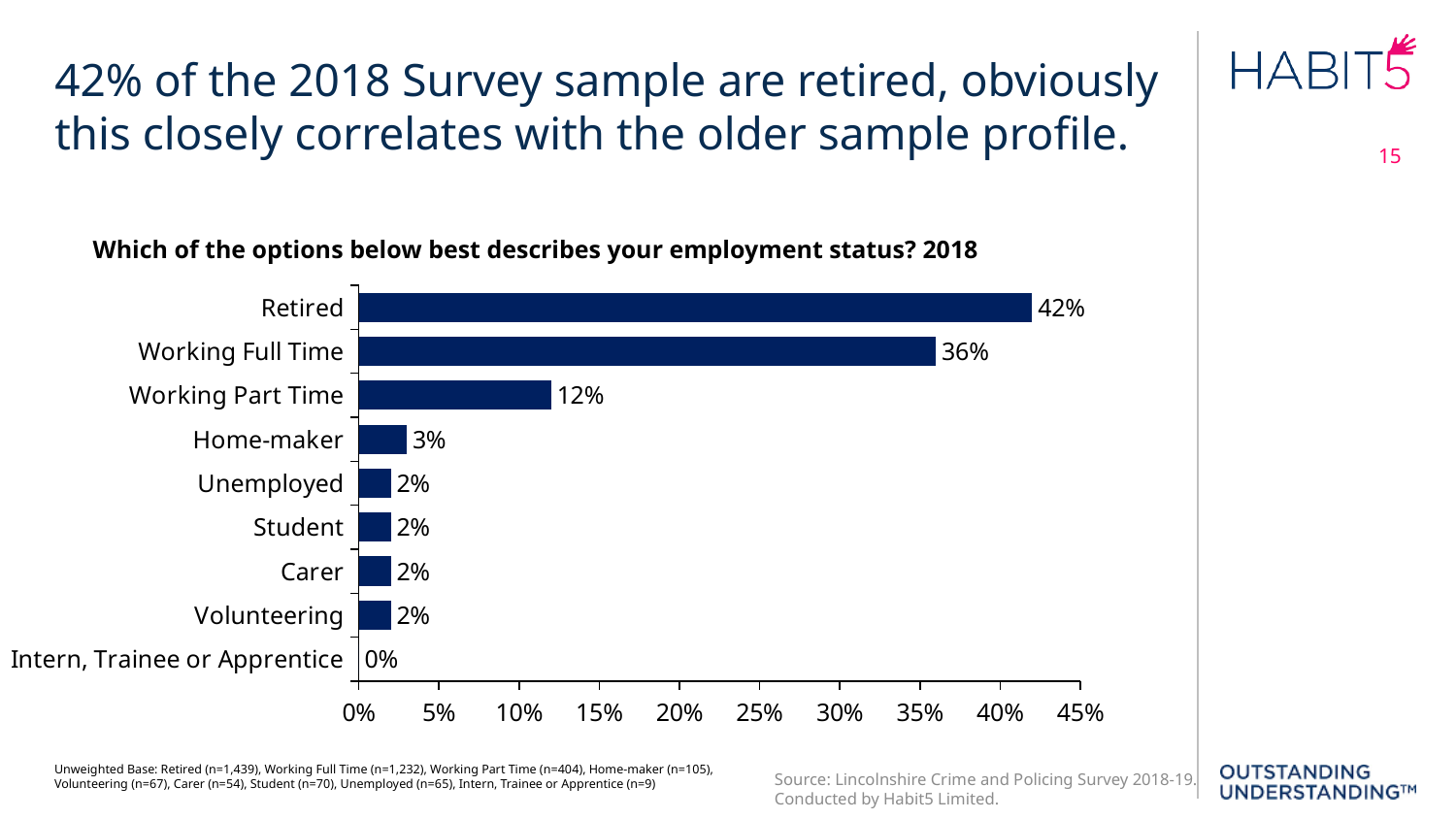
What is the title of the chart? Which of the options below best describes your employment status? 2018 Which employment status has the highest value? Retired What is the difference between Working Full Time and Working Part Time? 24% Which employment status has the lowest value? Intern, Trainee or Apprentice What is the value for Working Part Time? 12% What type of chart is shown on the slide? Bar chart Is the value for Working Full Time greater or less than 35%? greater What percentage of respondents are Retired? 42% How many employment status categories are shown in the chart? 9 Which is larger, Working Part Time or Home-maker? Working Part Time What percentage of respondents are Home-makers? 3% What is the difference between the Retired and Working Full Time values? 6%